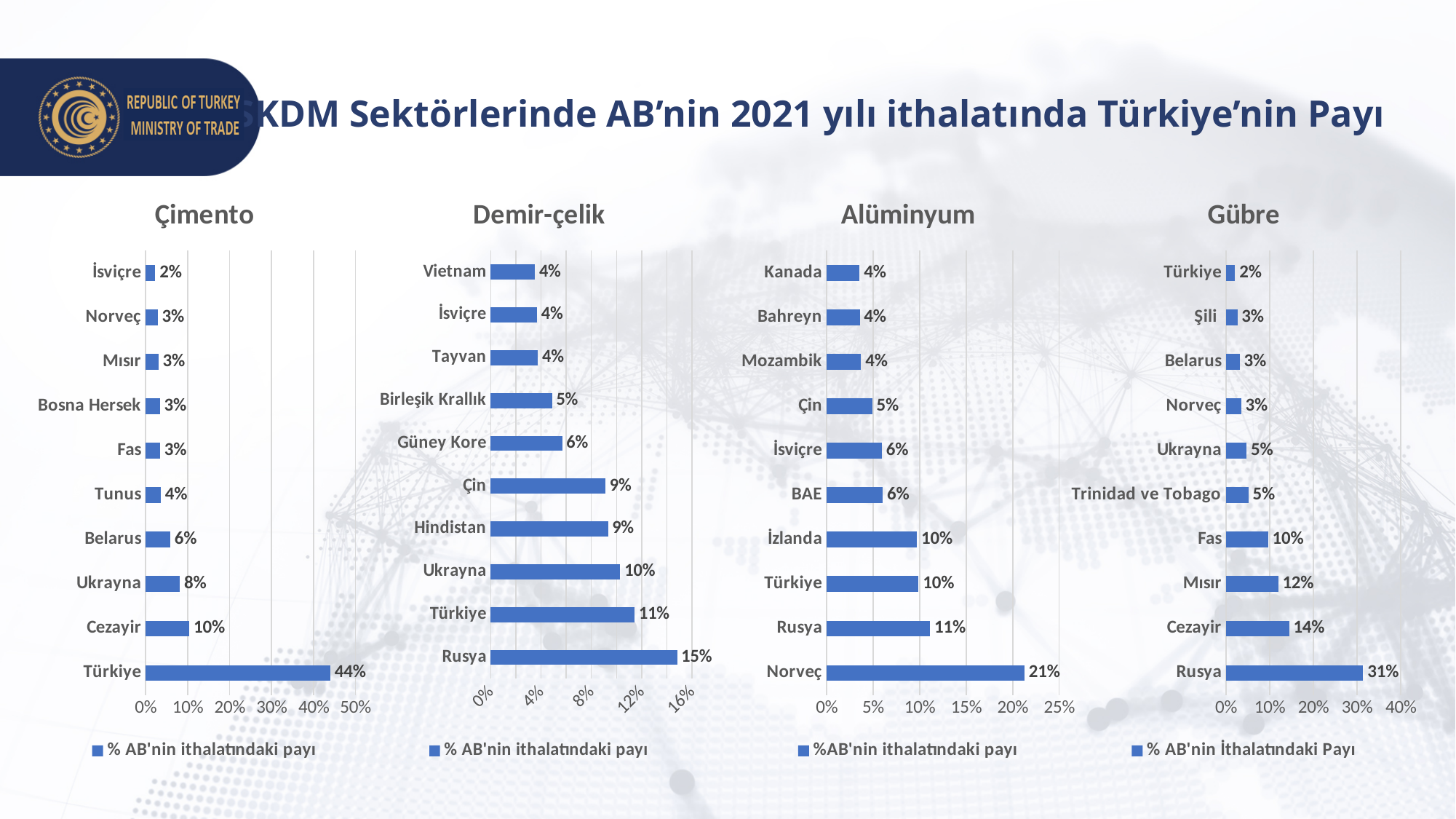
In the Çimento chart, which is larger, the value for Cezayir or the value for Ukrayna? Cezayir In the Gübre chart, what is the difference between the values for Rusya and Cezayir? 17% In the Çimento chart, what is the value for Türkiye? 44% In the Demir-çelik chart, what is the difference between the values for Rusya and Türkiye? 4% In the Alüminyum chart, what is the value for Türkiye? 10% In the Gübre chart, which country has the lowest value? Türkiye What kind of chart is the Çimento chart? Bar chart In the Alüminyum chart, how many series does the legend list? 1 In the Gübre chart, what is the value for Mısır? 12% In the Demir-çelik chart, how many countries are shown? 10 In the Alüminyum chart, what is the value for Norveç? 21% In the Demir-çelik chart, which country has the highest value? Rusya